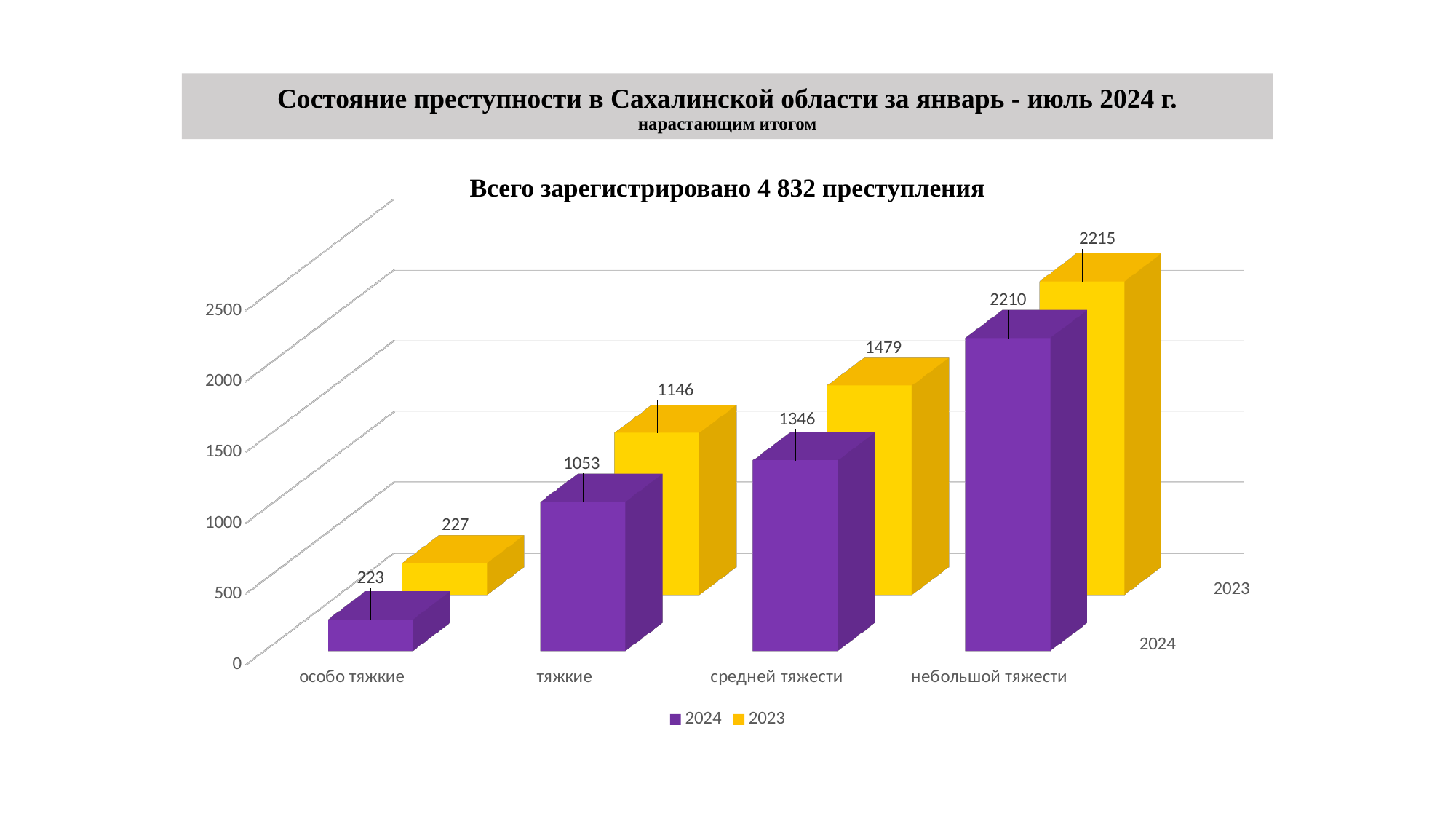
Which is larger in the category "тяжкие": the 2024 value or the 2023 value? 2023 Which category has the lowest value for the 2024 series? особо тяжкие What is the difference between the 2023 and 2024 values in the category "средней тяжести"? 133 What is the value for 2023 in the category "средней тяжести"? 1479 What is the difference between the 2023 and 2024 values in the category "тяжкие"? 93 How many categories are shown on the x axis? 4 What is the value for 2024 in the category "тяжкие"? 1053 Which category has the highest value for the 2023 series? небольшой тяжести How many series does the legend list? 2 What kind of chart is shown on the slide? bar chart What is the value for 2023 in the category "особо тяжкие"? 227 What is the value for 2024 in the category "небольшой тяжести"? 2210